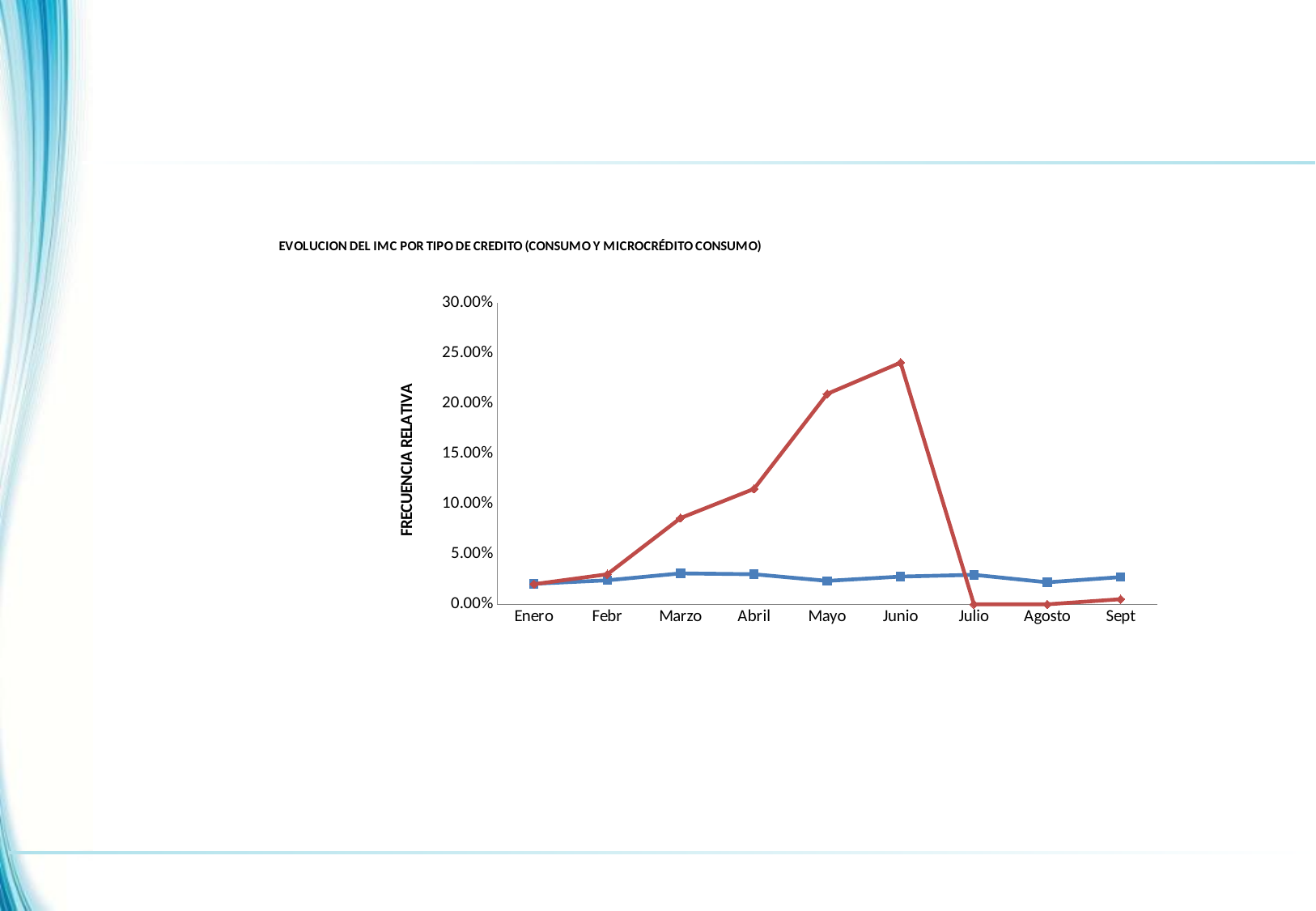
Is the value of the red line in Abril greater or less than 15.00%? less Is the value of the red line in Marzo greater or less than 10.00%? less How many months are shown along the x axis of the chart? 9 What is the title of the vertical axis of the chart? FRECUENCIA RELATIVA In which month does the red line reach its highest value? Junio Does the red line rise or fall from Junio to Julio? fall Is the value of the red line in Mayo greater or less than 15.00%? greater What kind of chart is shown on the slide? line chart Does the red line rise or fall from Enero to Junio? rise In Junio, which line has the larger value, the red line or the blue line? the red line